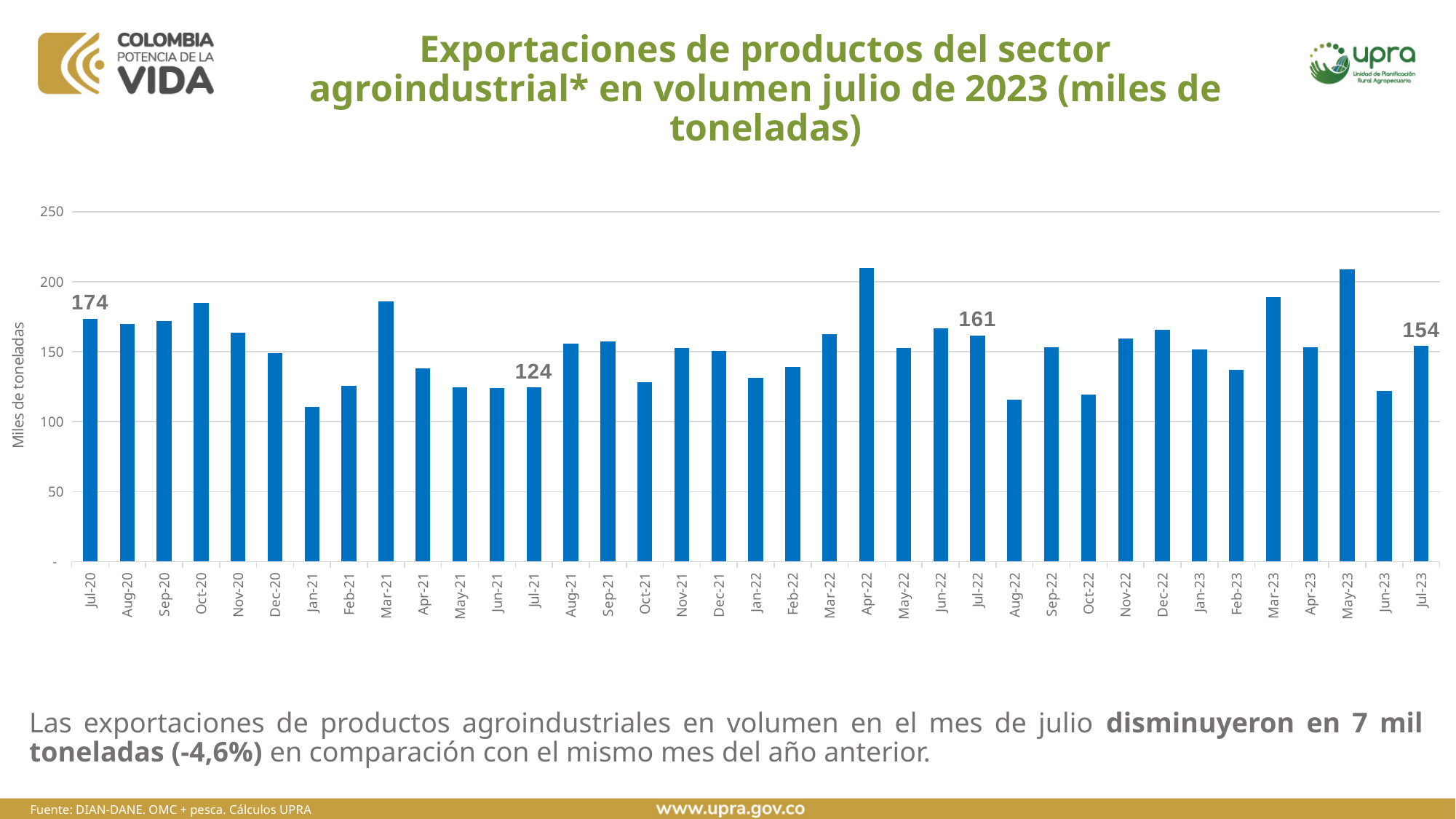
What kind of chart is shown on the slide? bar chart What is the value for Jul-22? 161 What is the difference between the values for Jul-20 and Jul-21? 50 What is the difference between the values for Jul-22 and Jul-23? 7 What is the value for Jul-20? 174 Is the value for Apr-22 greater or less than 200? greater How many months (bars) are shown on the chart? 37 What is the value for Jul-23? 154 Is the value for Mar-21 greater or less than 150? greater Is the value for Jan-21 greater or less than 150? less What is the value for Jul-21? 124 Which is larger, the value for Jul-20 or the value for Jul-23? Jul-20